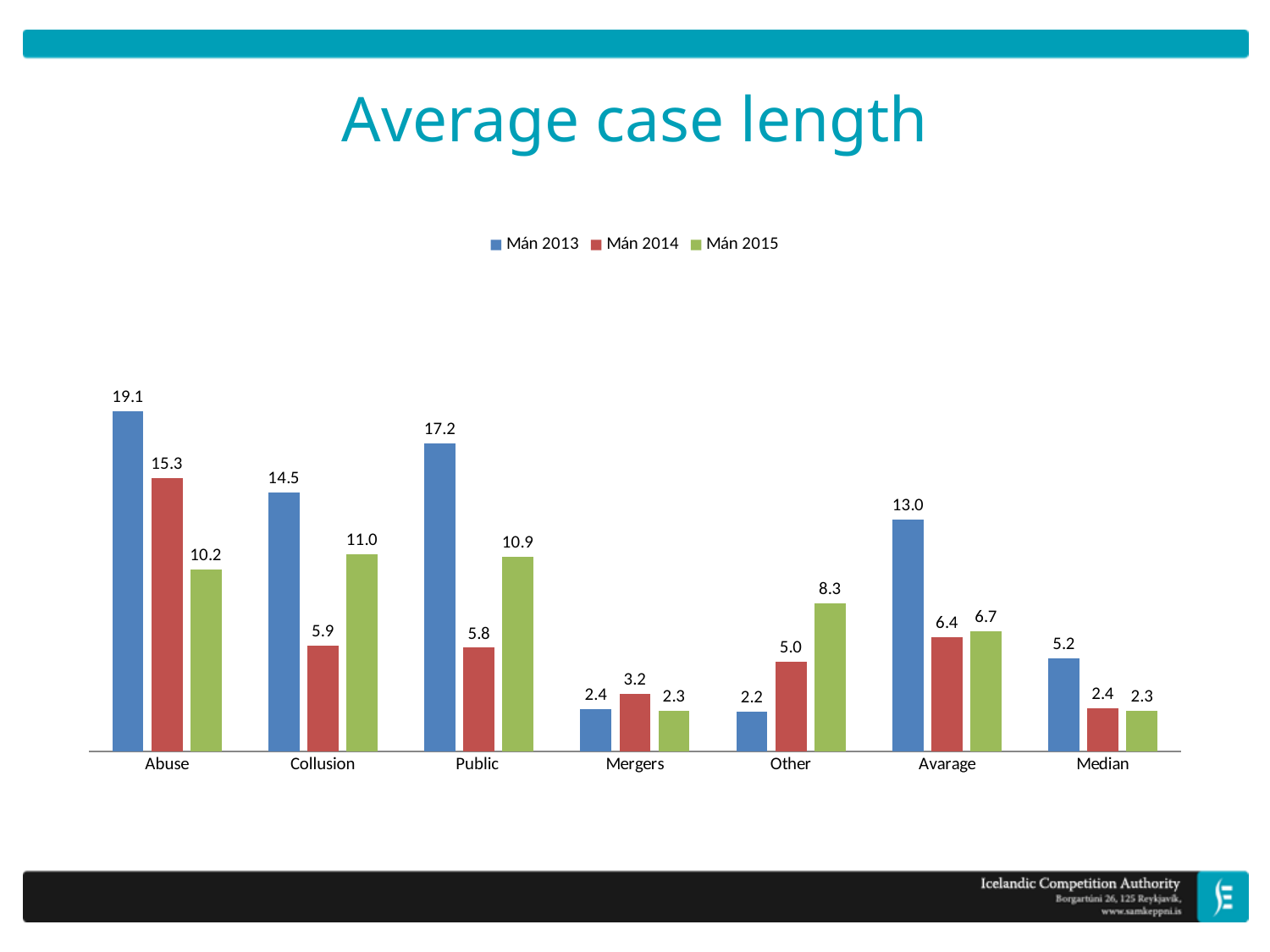
What is the title of the chart? Average case length What kind of chart is shown on the slide? Bar chart What is the value for Other in the Mán 2014 series? 5.0 Which series is shown in green in the legend? Mán 2015 What is the value for Collusion in the Mán 2015 series? 11.0 How many series does the legend list? 3 How many categories are shown on the x axis? 7 What is the difference between the Mán 2013 and Mán 2014 values for Public? 11.4 Which category has the highest value in the Mán 2013 series? Abuse Which is larger for Other: the Mán 2014 value or the Mán 2015 value? Mán 2015 What is the value for Abuse in the Mán 2013 series? 19.1